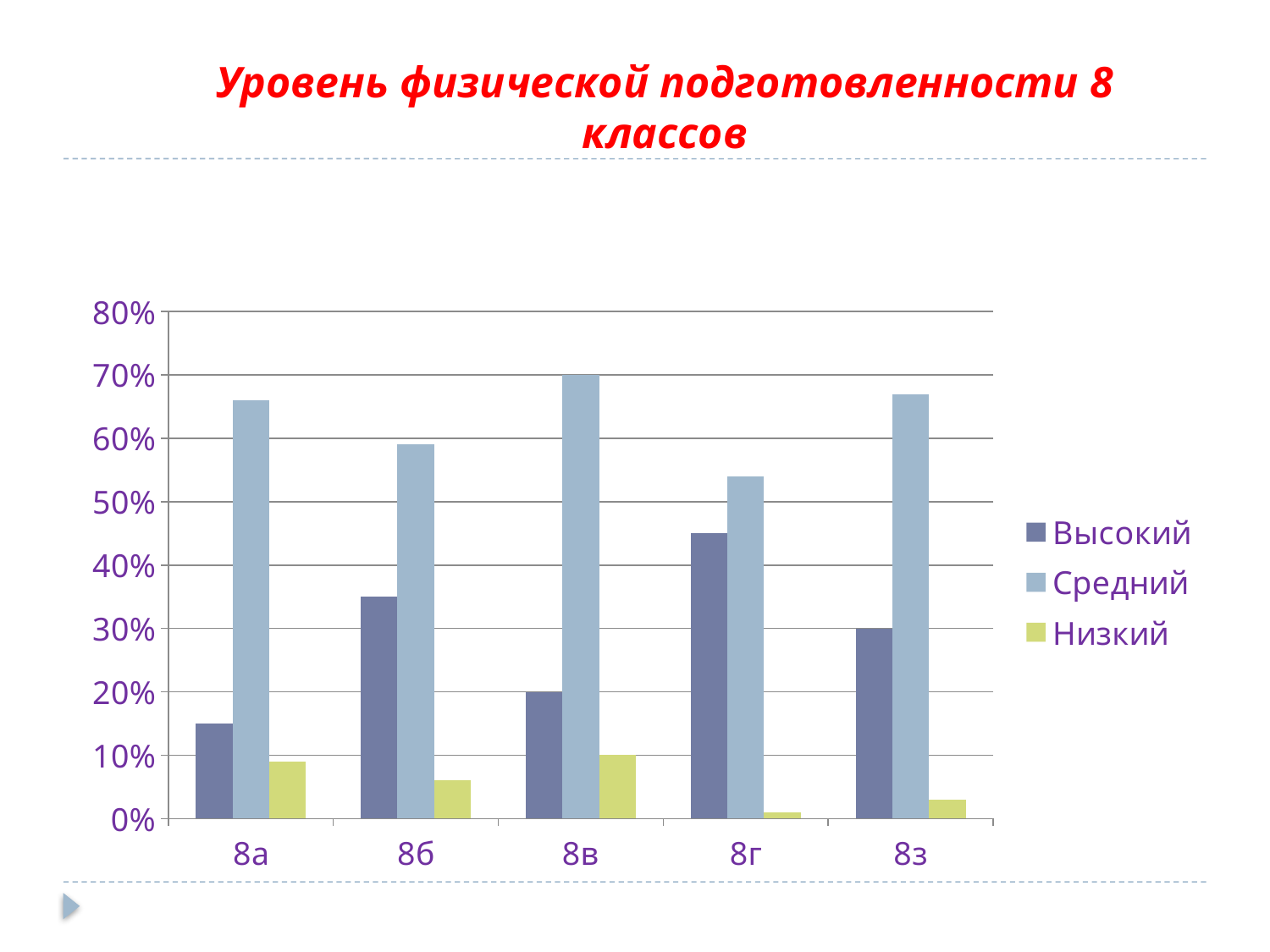
Is the value for Высокий in class 8а greater or less than 20%? less How many classes (categories) are shown on the x axis? 5 Which class has the highest value for Высокий? 8г Which class has the lowest value for Высокий? 8а Which class has the highest value for Средний? 8в Is the value for Средний in class 8г greater or less than 50%? greater What are the three entries listed in the legend? Высокий, Средний, Низкий Which is larger: the Высокий value for 8б or for 8з? 8б Which is larger: the Средний value for 8а or for 8б? 8а Which class has the lowest value for Низкий? 8г How many series does the legend list? 3 What kind of chart is shown on the slide? bar chart